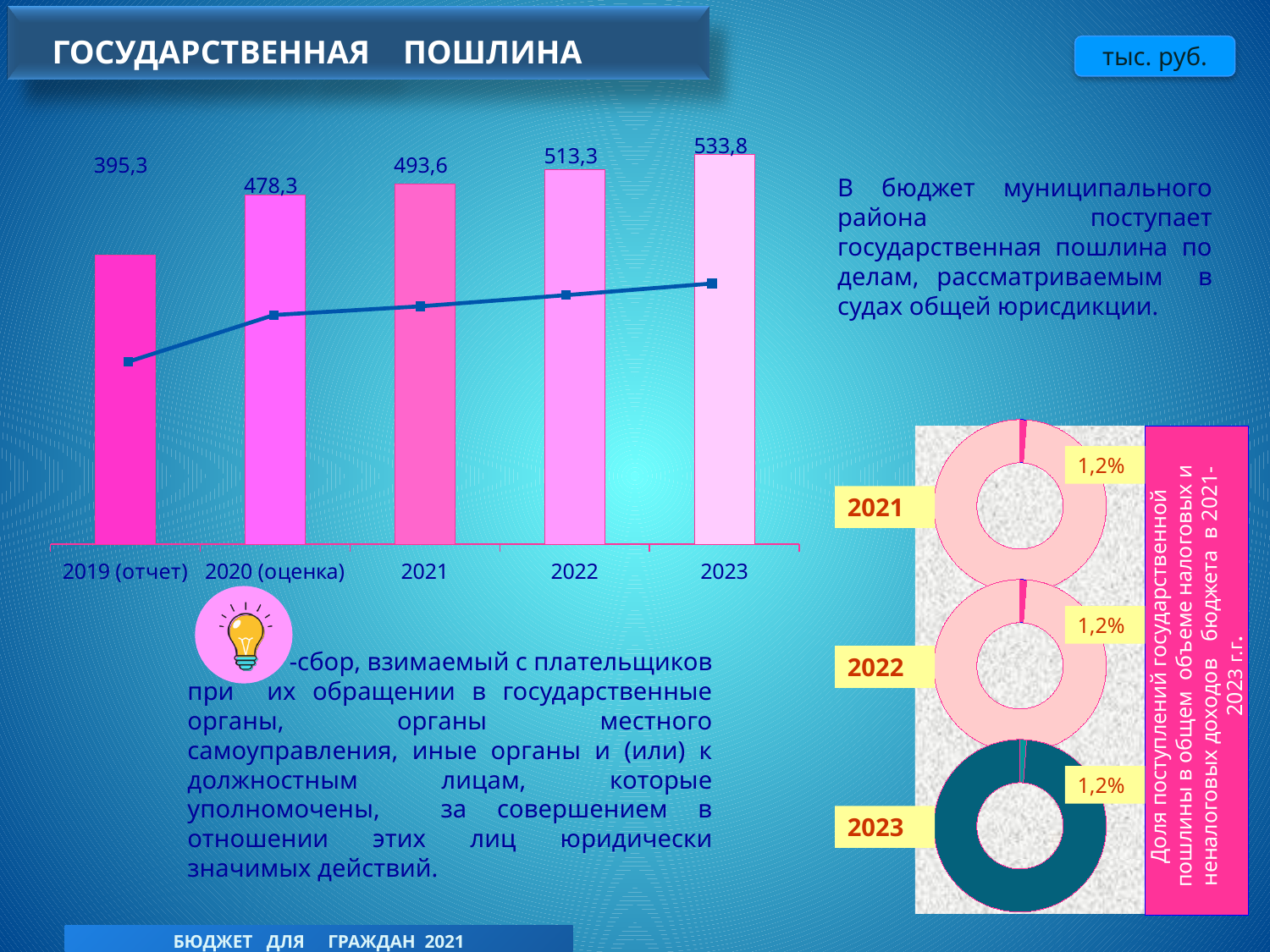
In the bar chart, which year has the lowest value? 2019 (отчет) In the bar chart, which is larger: the value for 2021 or the value for 2020 (оценка)? 2021 In the bar chart, what is the difference between the values for 2023 and 2019 (отчет)? 138,5 What unit is indicated for the values in the bar chart? тыс. руб. In the bar chart, what is the value for 2022? 513,3 Do the values in the bar chart rise or fall from 2019 to 2023? rise In the bar chart, what is the value for 2019 (отчет)? 395,3 In the bar chart, which year has the highest value? 2023 How many years (categories) are shown in the bar chart? 5 In the bar chart, what is the difference between the values for 2022 and 2021? 19,7 In the donut charts on the right, what share is shown for 2023? 1,2% In the bar chart, what is the value for 2020 (оценка)? 478,3